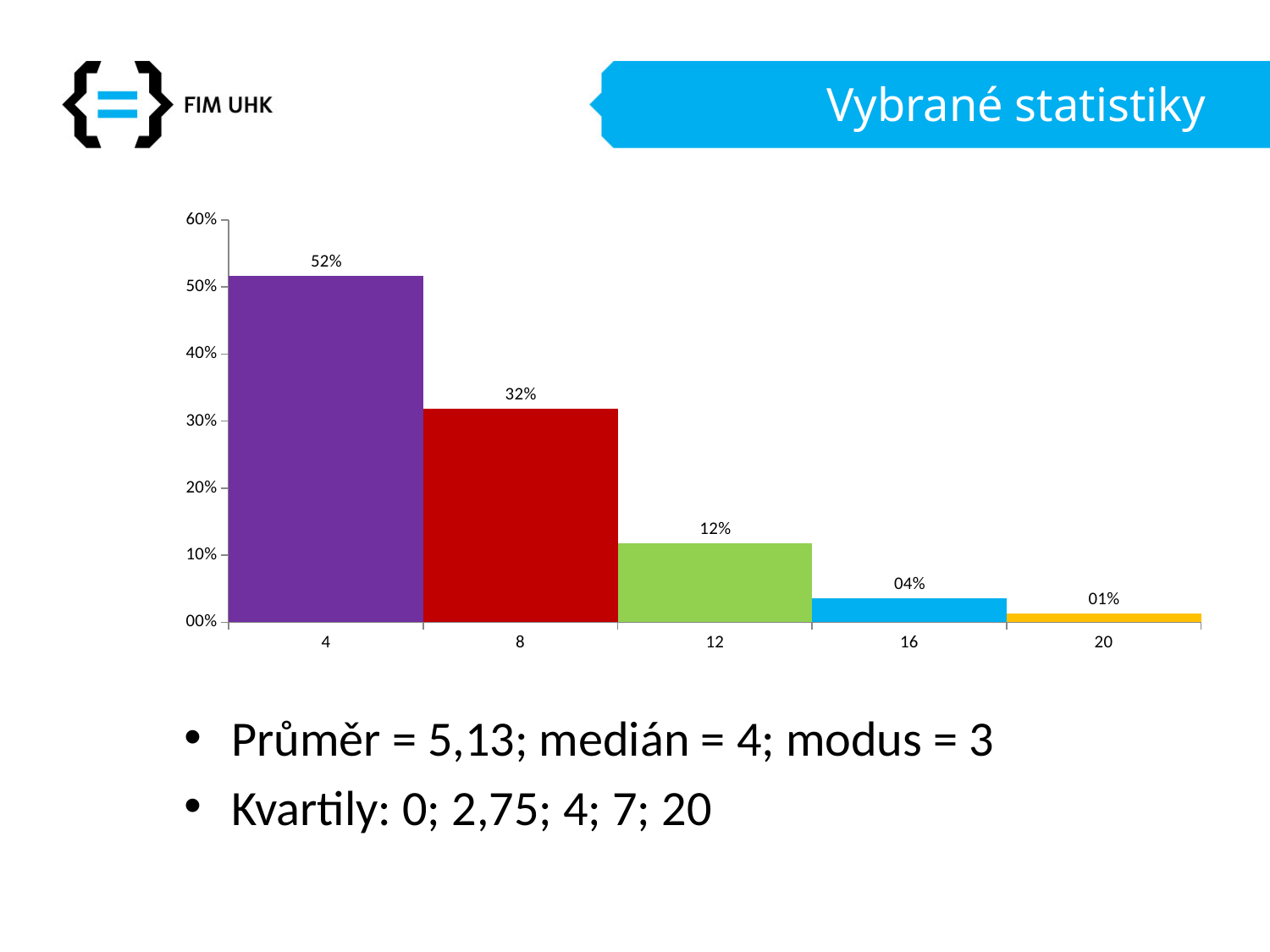
What is the value for category 4? 52% Do the values rise or fall from left to right along the x axis? fall Which category has the highest value? 4 What kind of chart is shown on the slide? bar chart What is the value for category 20? 01% Which category has the lowest value? 20 Is the value for category 8 greater or less than 30%? greater How many categories are shown on the x axis? 5 What is the value for category 8? 32% Which is larger, the value for category 12 or the value for category 16? 12 What is the difference between the values for categories 4 and 8? 20% What is the value for category 12? 12%